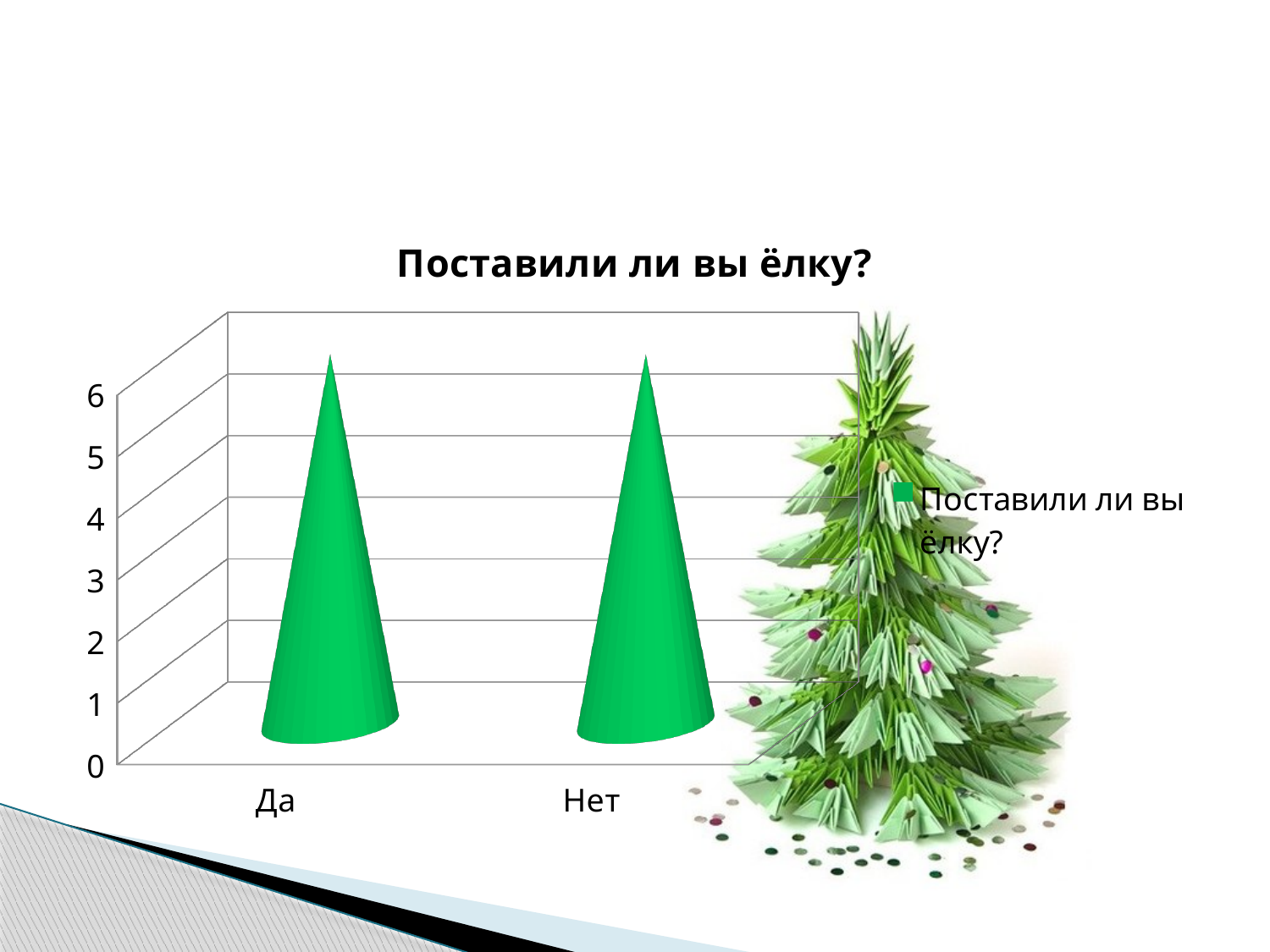
Is the value for Да greater or less than 4? greater What is the title of the chart? Поставили ли вы ёлку? How many categories are shown on the x axis of the chart? 2 How many series does the chart legend list? 1 What is the highest value shown on the vertical axis? 6 Is the value for Нет greater or less than 4? greater Is the value for Нет greater or less than 3? greater What kind of chart is shown on the slide? bar chart What are the two category labels on the x axis? Да, Нет